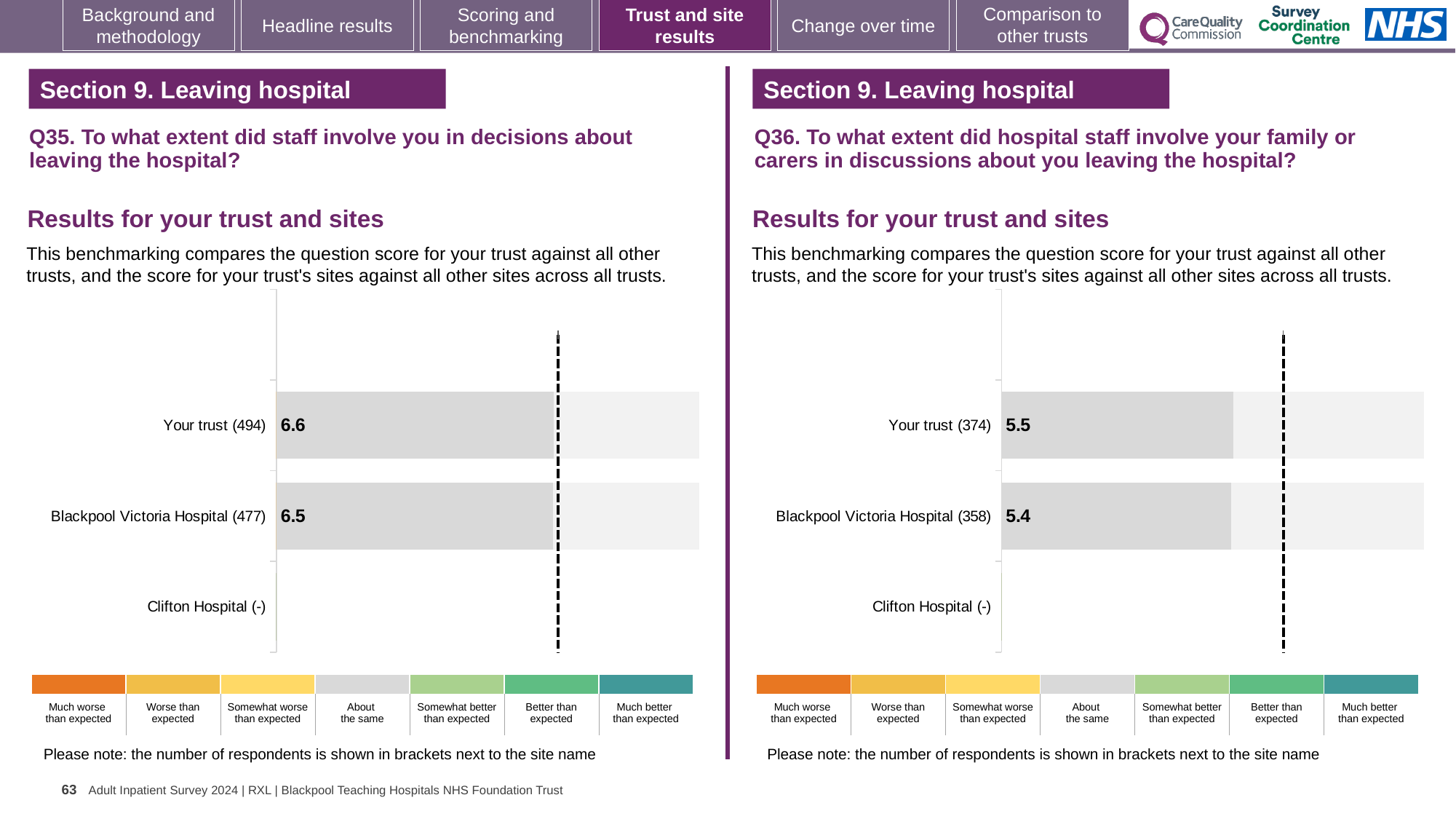
In the Q35 chart on the left, how many respondents are shown in brackets for Blackpool Victoria Hospital? 477 In the Q36 chart on the right, what is the score for Blackpool Victoria Hospital (358)? 5.4 In the Q36 chart on the right, which has the higher score, Your trust or Blackpool Victoria Hospital? Your trust In the Q35 chart on the left, which has the higher score, Your trust or Blackpool Victoria Hospital? Your trust In the Q35 chart on the left, what is the score for Your trust (494)? 6.6 In the Q35 chart on the left, what is the score for Blackpool Victoria Hospital (477)? 6.5 In the Q36 chart on the right, which site has no score shown (marked with a dash)? Clifton Hospital In the Q35 chart on the left, what is the difference between the score for Your trust and the score for Blackpool Victoria Hospital? 0.1 In the Q36 chart on the right, what is the score for Your trust (374)? 5.5 How many categories (rows) are listed in the Q35 chart on the left? 3 In the Q36 chart on the right, what is the difference between the score for Your trust and the score for Blackpool Victoria Hospital? 0.1 What type of chart is used for the Q36 results on the right? Bar chart